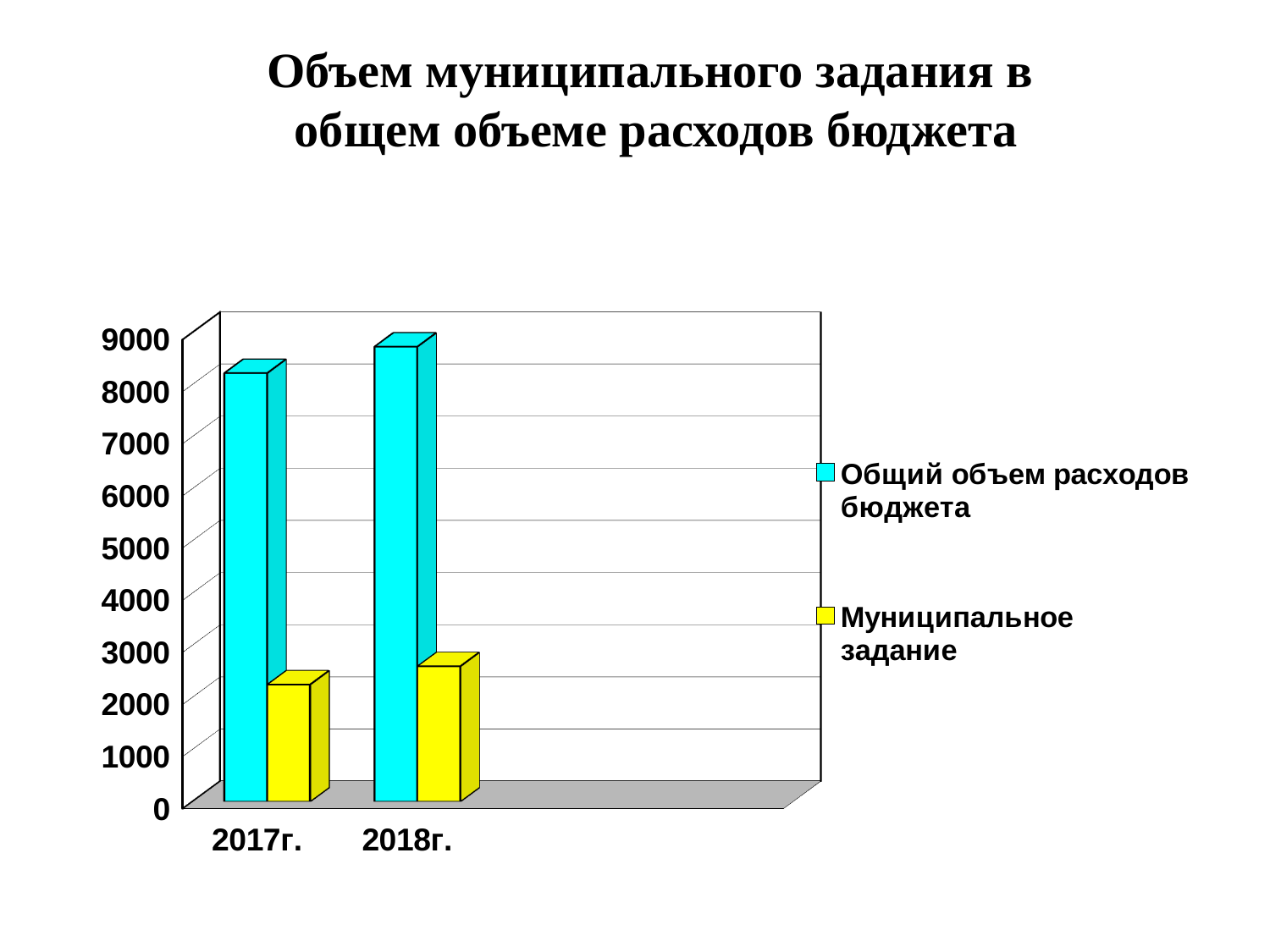
What is the title of the chart? Объем муниципального задания в общем объеме расходов бюджета Which year has the larger value for Общий объем расходов бюджета, 2017г. or 2018г.? 2018г. Is the value of Общий объем расходов бюджета for 2017г. greater or less than 7000? greater Do the values of Муниципальное задание rise or fall from 2017г. to 2018г.? rise How many categories are shown on the x axis? 2 Is the value of Муниципальное задание for 2018г. greater or less than 2000? greater Is the value of Общий объем расходов бюджета for 2018г. greater or less than 8000? greater Which year has the larger value for Муниципальное задание, 2017г. or 2018г.? 2018г. What kind of chart is shown on the slide? bar chart How many series does the legend list? 2 Which series is shown in yellow? Муниципальное задание